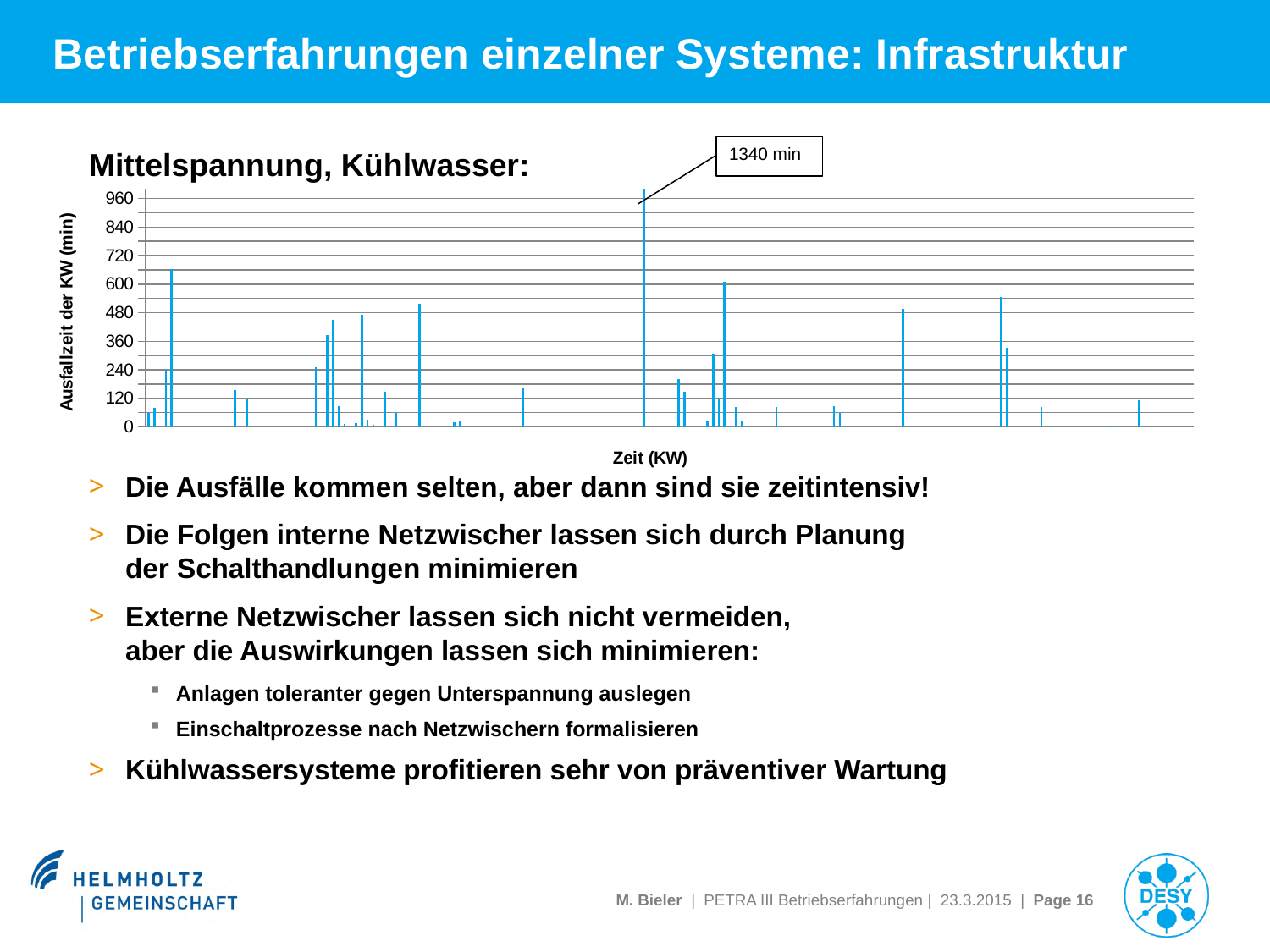
Is the value of the tallest bar greater or less than 960? greater What heading is printed above the chart? Mittelspannung, Kühlwasser: What is the title of the y axis of the chart? Ausfallzeit der KW (min) What is the value of the tallest bar in the chart, as given by the annotation? 1340 min What kind of chart is shown on the slide? bar chart What is the highest tick value shown on the y axis of the chart? 960 What is the interval between consecutive tick values on the y axis? 120